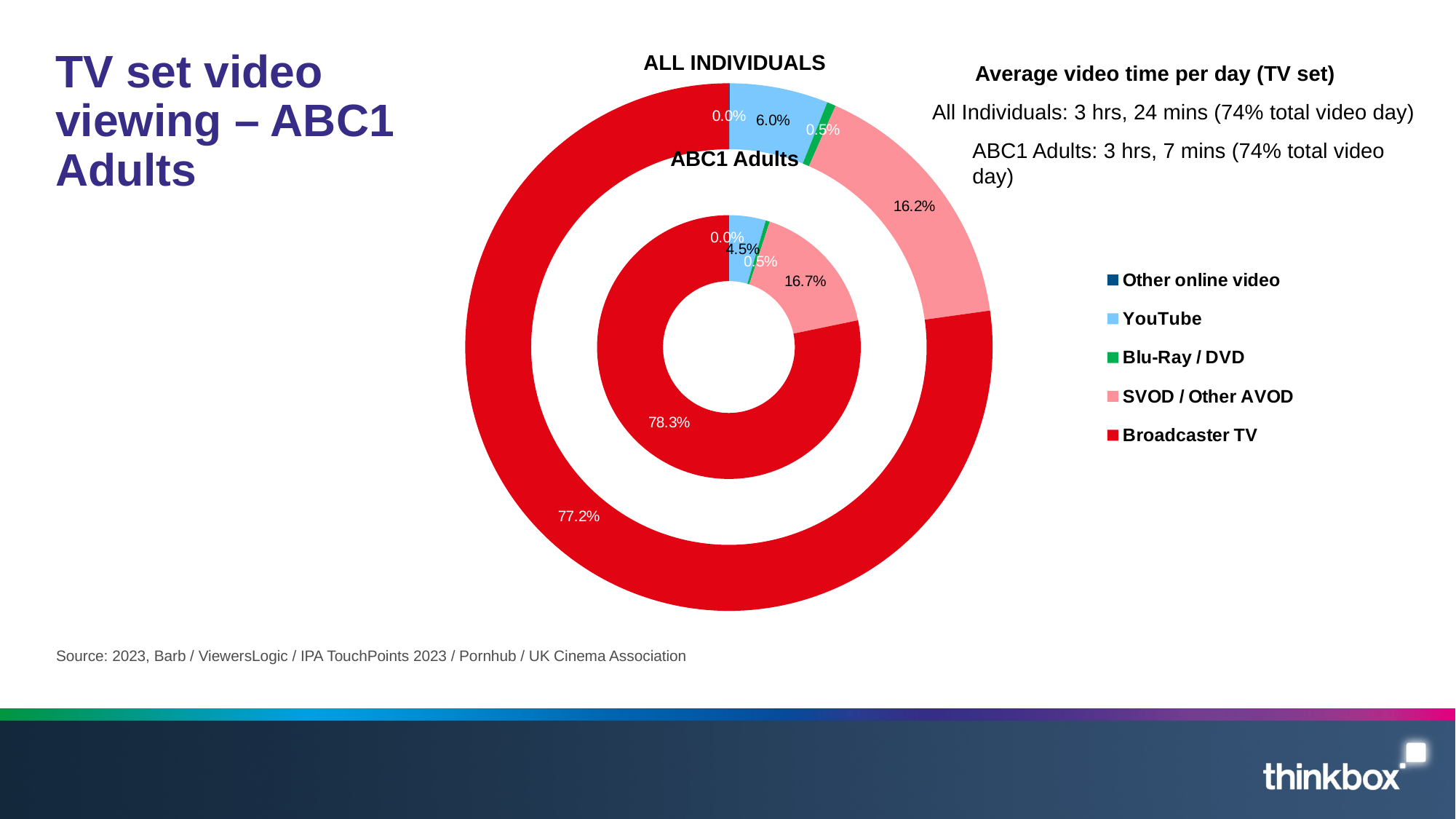
Which category has the smallest share in the All Individuals ring? Other online video What is the Broadcaster TV share for All Individuals? 77.2% What is the SVOD / Other AVOD share for ABC1 Adults? 16.7% What is the Blu-Ray / DVD share for All Individuals? 0.5% What is the difference between the SVOD / Other AVOD share for ABC1 Adults and for All Individuals? 0.5% What is the YouTube share for All Individuals? 6.0% Which is larger: the YouTube share for All Individuals or for ABC1 Adults? All Individuals What is the Broadcaster TV share for ABC1 Adults? 78.3% What kind of chart is shown on the slide? Doughnut chart Which category has the largest share in the ABC1 Adults ring? Broadcaster TV What is the YouTube share for ABC1 Adults? 4.5% How many categories does the legend list? 5